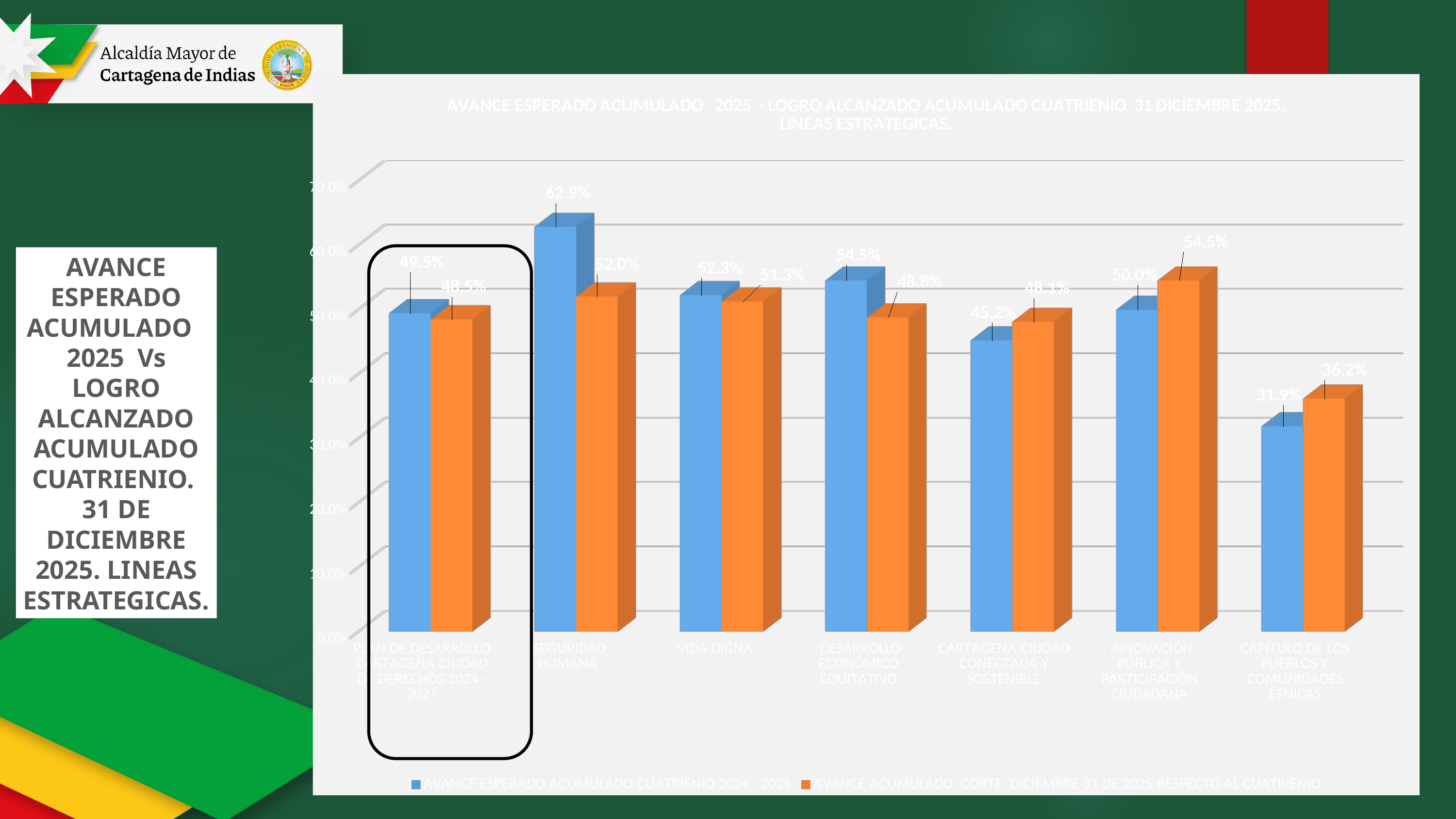
How many categories are shown on the x axis? 7 Is the expected accumulated progress for Capítulo de los Pueblos y Comunidades Étnicas greater or less than 40.0%? less How many series does the legend list? 2 Which category has the highest expected accumulated progress (blue series)? Seguridad Humana Which colour represents the series AVANCE ESPERADO ACUMULADO CUATRIENIO 2024 - 2025? Blue What is the achieved accumulated progress (orange series) for Capítulo de los Pueblos y Comunidades Étnicas? 36.2% What is the expected accumulated progress (blue series) for Seguridad Humana? 62.9% What is the achieved accumulated progress (orange series) for Innovación Pública y Participación Ciudadana? 54.5% Which category has the lowest achieved accumulated progress (orange series)? Capítulo de los Pueblos y Comunidades Étnicas What kind of chart is shown on the slide? Bar chart What is the difference between the expected (62.9%) and achieved (52.0%) values for Seguridad Humana? 10.9% For Cartagena Ciudad Conectada y Sostenible, which is larger: the expected value or the achieved value? The achieved value (48.1%)